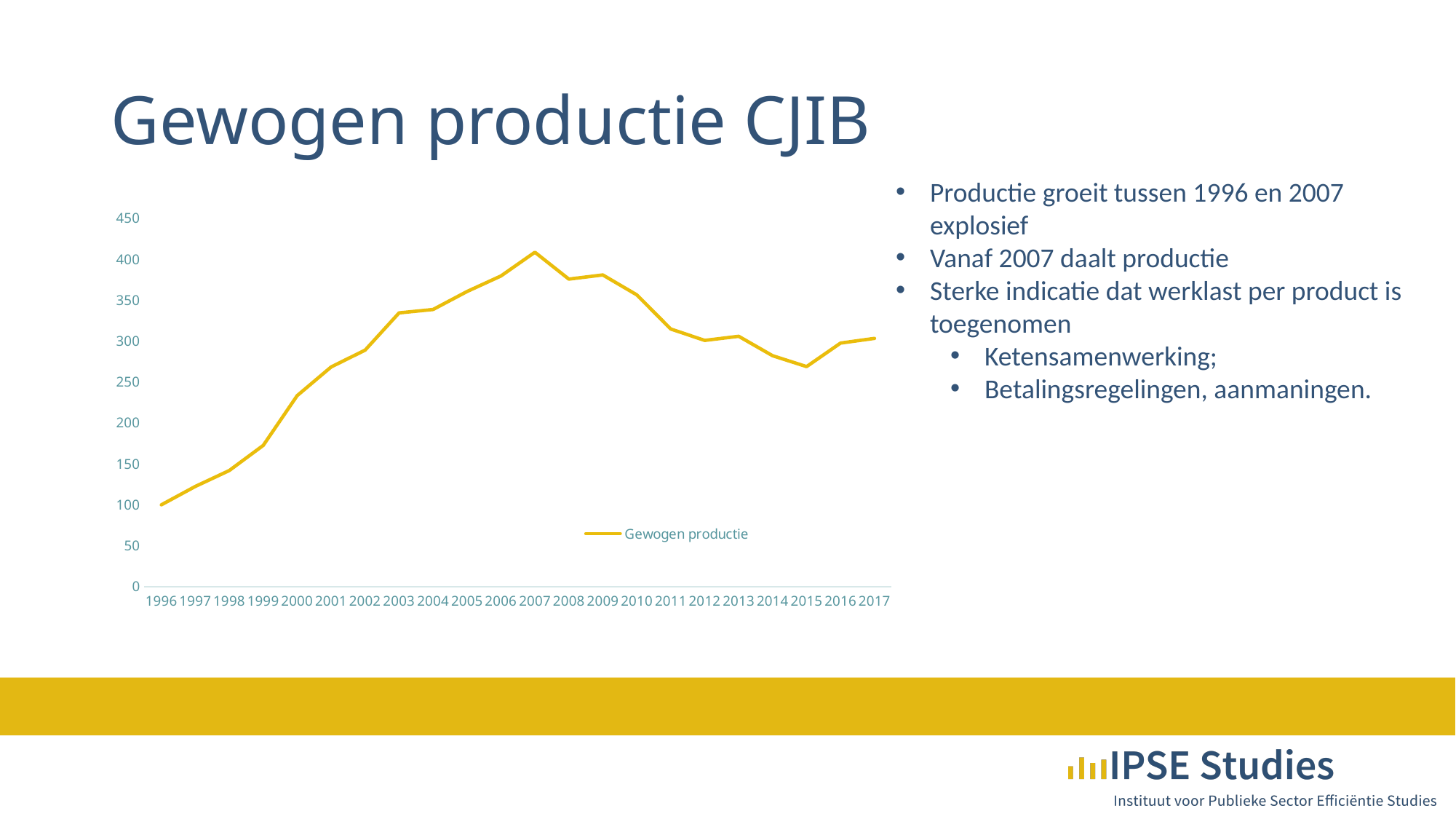
Is the value for 2000 greater or less than 250? less Is the value for 2015 greater or less than 300? less Is the value for 2009 greater or less than 350? greater In which year is Gewogen productie at its lowest? 1996 Which year has the larger value, 2007 or 2017? 2007 Does Gewogen productie rise or fall between 1996 and 2007? rise What kind of chart is shown on the slide? line chart How many series does the legend list? 1 How many years are plotted along the x axis? 22 What is the name of the series shown in the legend? Gewogen productie In which year does Gewogen productie reach its highest value? 2007